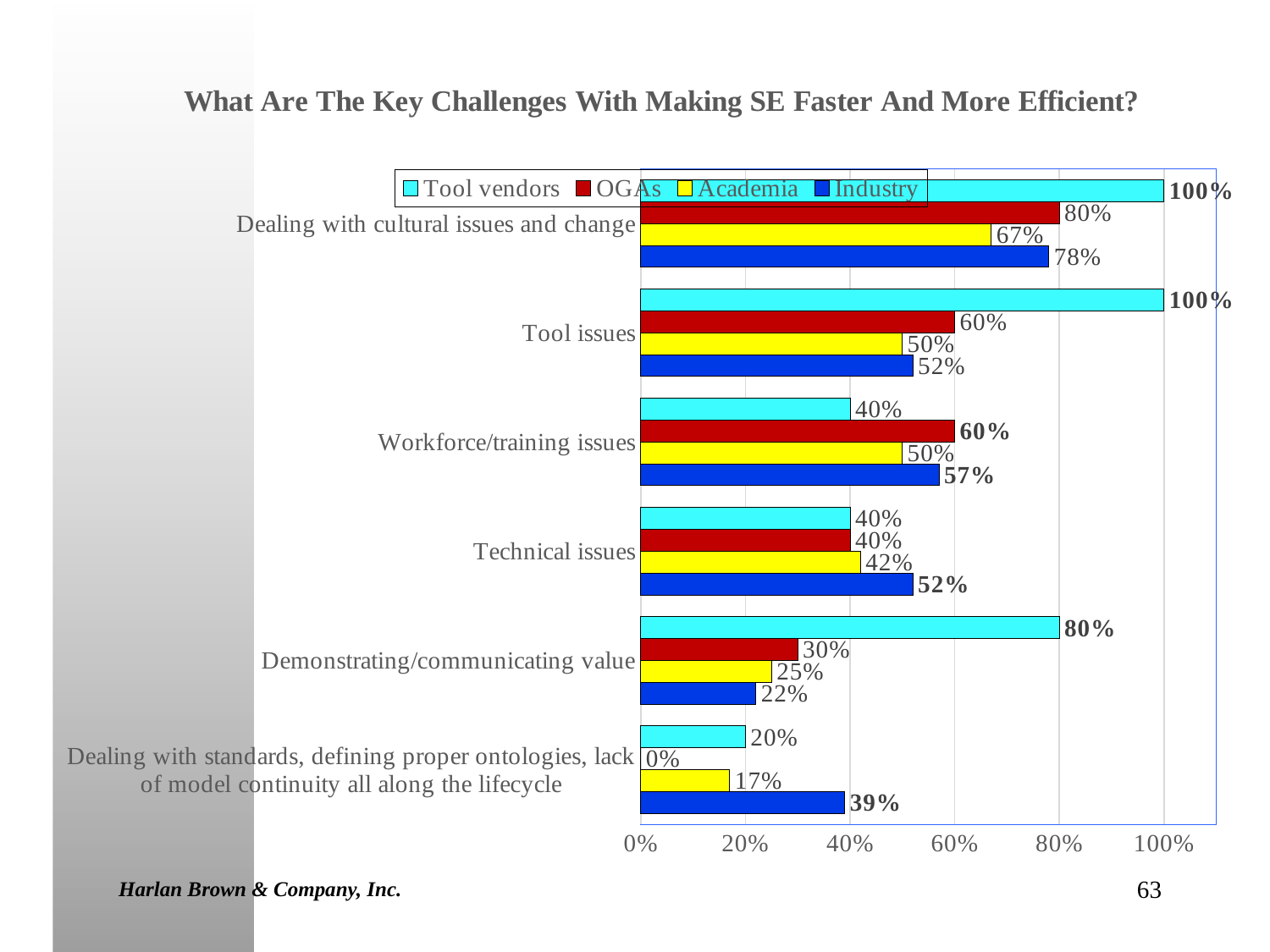
What is the OGAs value for Dealing with standards, defining proper ontologies, lack of model continuity all along the lifecycle? 0% What kind of chart is shown on the slide? Bar chart Which category has the highest Industry value? Dealing with cultural issues and change What is the difference between the Tool vendors and OGAs values for Demonstrating/communicating value? 50% Which series has the lowest value for Demonstrating/communicating value? Industry How many challenge categories are plotted on the chart? 6 Which series has the highest value for Workforce/training issues? OGAs What is the Industry value for Dealing with cultural issues and change? 78% How many series does the legend list? 4 For Technical issues, which is larger: the Industry value or the Academia value? Industry What is the Academia value for Tool issues? 50% What colour represents the Academia series in the legend? Yellow